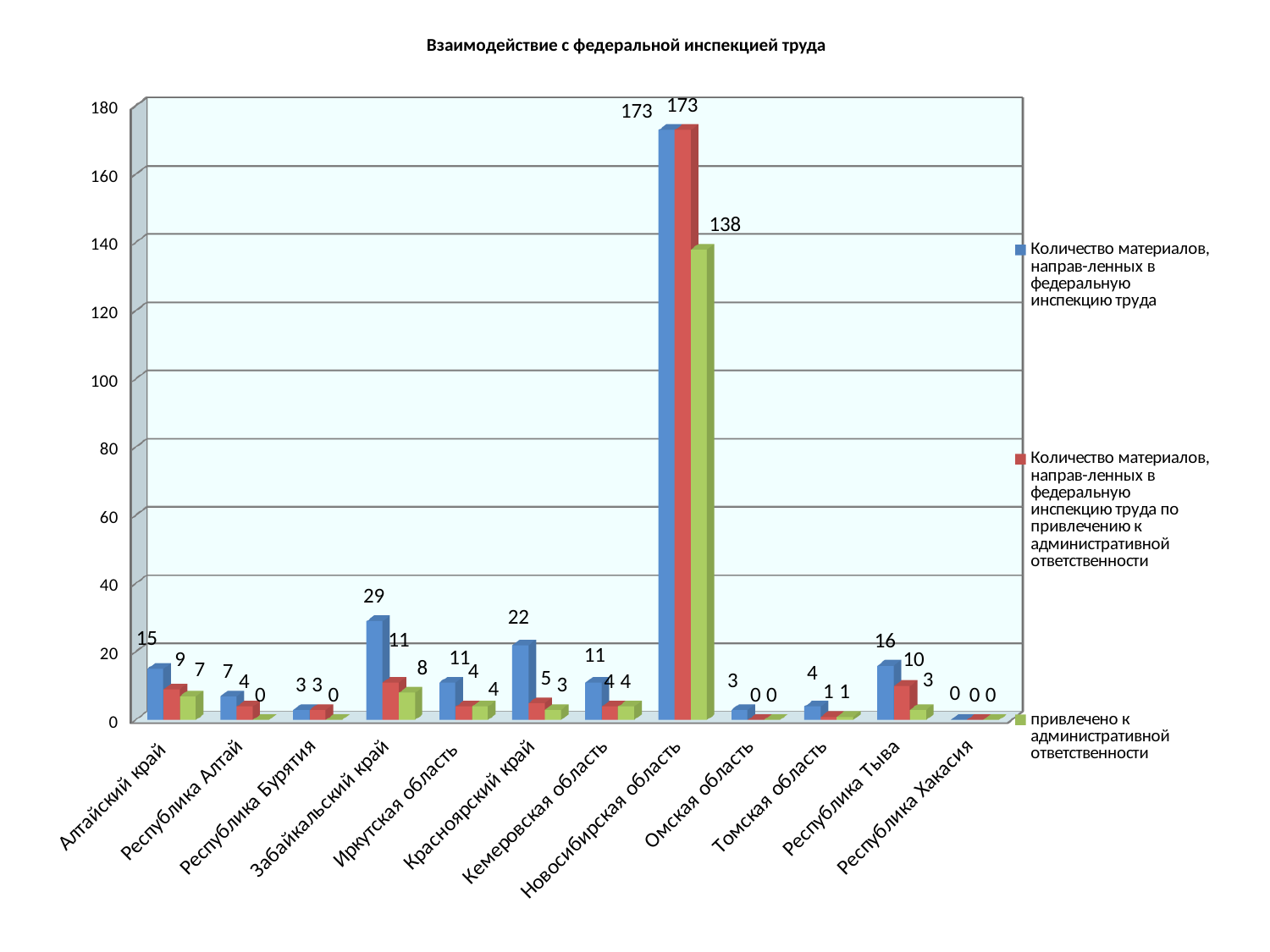
Which region has the highest value for the first series (materials sent to the federal labour inspection)? Новосибирская область How many regions are shown on the x axis? 12 What kind of chart is shown on the slide? bar chart What is the difference between the first series value and the third series value for Новосибирская область? 35 Is the first series value for Новосибирская область greater or less than 160? greater Which is larger: the first series value for Красноярский край or for Республика Тыва? Красноярский край What is the title of the chart? Взаимодействие с федеральной инспекцией труда What is the value of the second series (materials sent for administrative liability) for Республика Тыва? 10 Which region has the lowest value for the first series (materials sent to the federal labour inspection)? Республика Хакасия What is the value of the first series (Количество материалов, направленных в федеральную инспекцию труда) for Забайкальский край? 29 How many series does the legend list? 3 What is the value of the third series (привлечено к административной ответственности) for Новосибирская область? 138